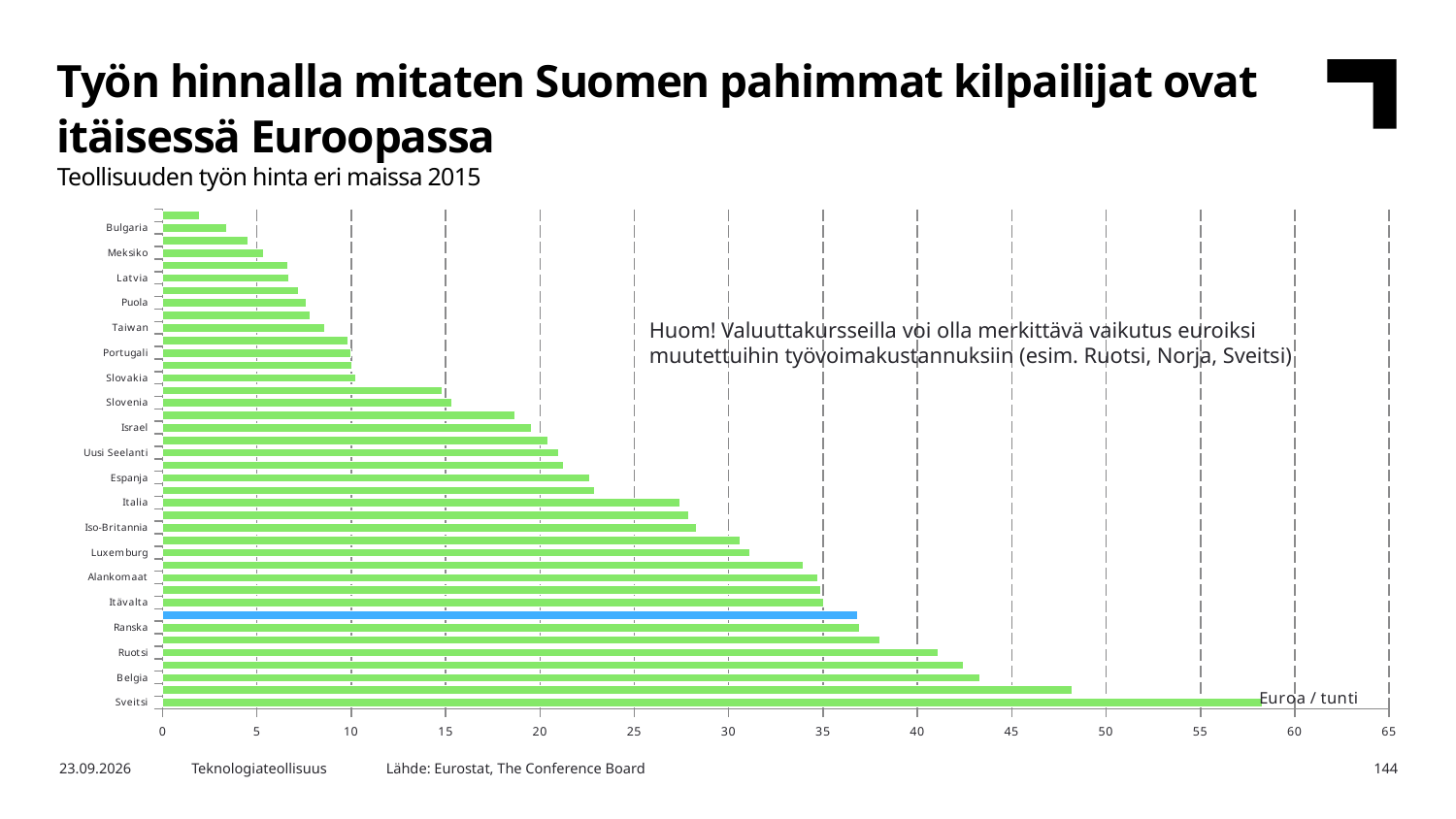
What unit is shown at the end of the x axis of the chart? Euroa / tunti What kind of chart is shown on the slide? bar chart Is the value for Iso-Britannia greater or less than 25? greater Is the value for Belgia greater or less than 40? greater Is the value for Italia greater or less than 25? greater Which country has the highest labour cost in the chart? Sveitsi Do the bar values increase or decrease going from the top of the chart to the bottom? increase Which has a higher value, Belgia or Espanja? Belgia